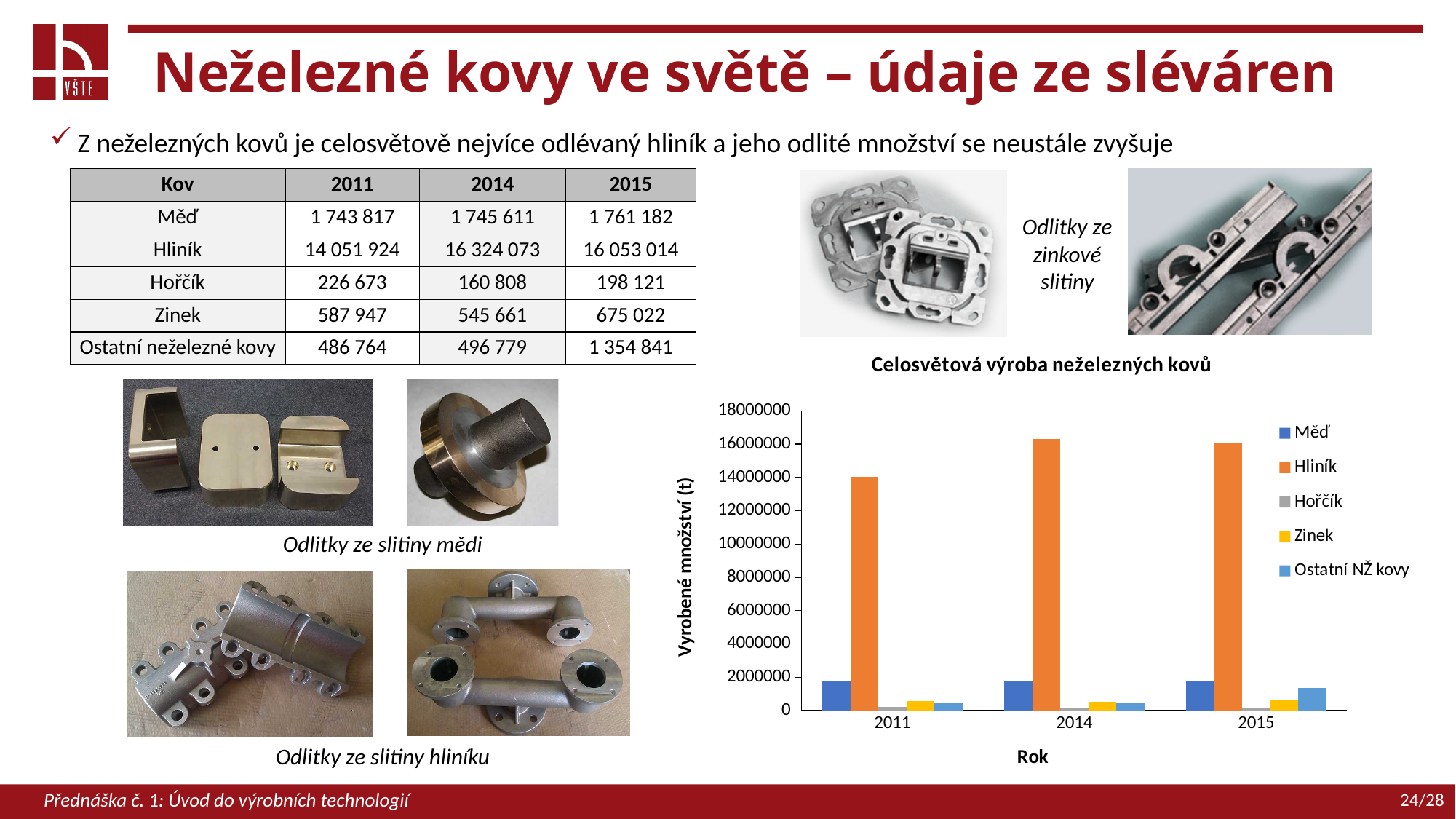
How many years are shown on the x axis of the chart 'Celosvětová výroba neželezných kovů'? 3 What is the y-axis title of the chart 'Celosvětová výroba neželezných kovů'? Vyrobené množství (t) In the chart 'Celosvětová výroba neželezných kovů', is the value for Měď in 2015 greater or less than 2000000? less What kind of chart is 'Celosvětová výroba neželezných kovů'? bar chart In the chart 'Celosvětová výroba neželezných kovů', which metal has the highest value in 2014? Hliník In the chart 'Celosvětová výroba neželezných kovů', which metal has the lowest value in 2015? Hořčík In the chart 'Celosvětová výroba neželezných kovů', is the value for Ostatní NŽ kovy larger in 2011 or in 2015? 2015 How many series does the legend of the chart 'Celosvětová výroba neželezných kovů' list? 5 In the chart 'Celosvětová výroba neželezných kovů', is the value for Hliník in 2014 greater or less than 14000000? greater In the chart 'Celosvětová výroba neželezných kovů', is the value for Hliník in 2011 greater or less than 12000000? greater What is the x-axis title of the chart 'Celosvětová výroba neželezných kovů'? Rok In the chart 'Celosvětová výroba neželezných kovů', does the value for Hliník rise or fall from 2011 to 2014? rise